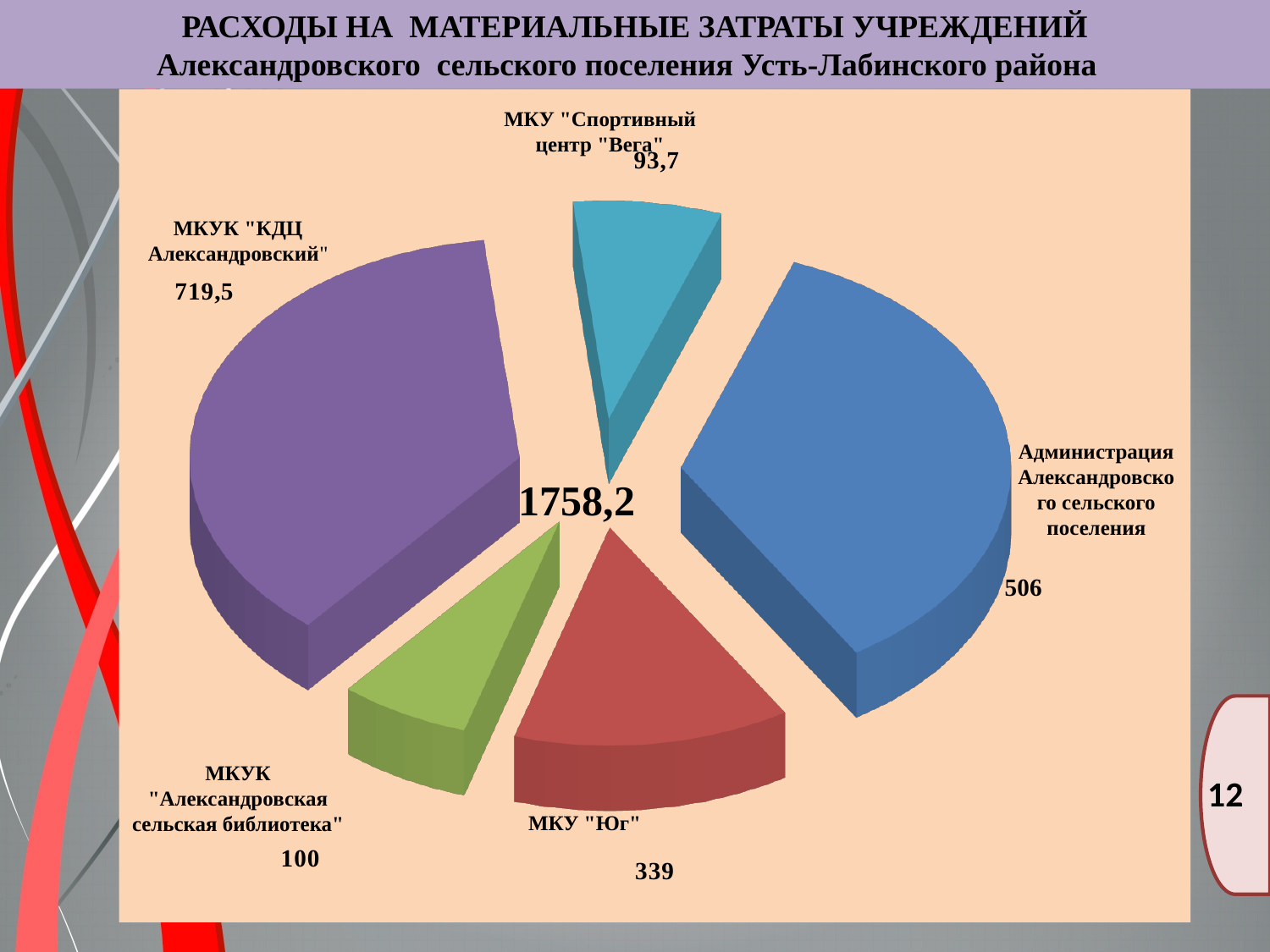
What value is shown for МКУК "КДЦ Александровский"? 719,5 Which institution has the largest slice of the pie? МКУК "КДЦ Александровский" What kind of chart is shown on the slide? Pie chart How many slices does the pie chart have? 5 What value is shown for МКУ "Юг"? 339 What is the difference between the values for МКУ "Юг" and МКУК "Александровская сельская библиотека"? 239 Which is larger: the value for МКУ "Юг" or the value for Администрация Александровского сельского поселения? Администрация Александровского сельского поселения What total value is printed in the centre of the pie chart? 1758,2 What value is shown for МКУ "Спортивный центр "Вега""? 93,7 What is the difference between the values for МКУК "КДЦ Александровский" and Администрация Александровского сельского поселения? 213,5 Which institution has the smallest slice of the pie? МКУ "Спортивный центр "Вега"" What value is shown for Администрация Александровского сельского поселения? 506